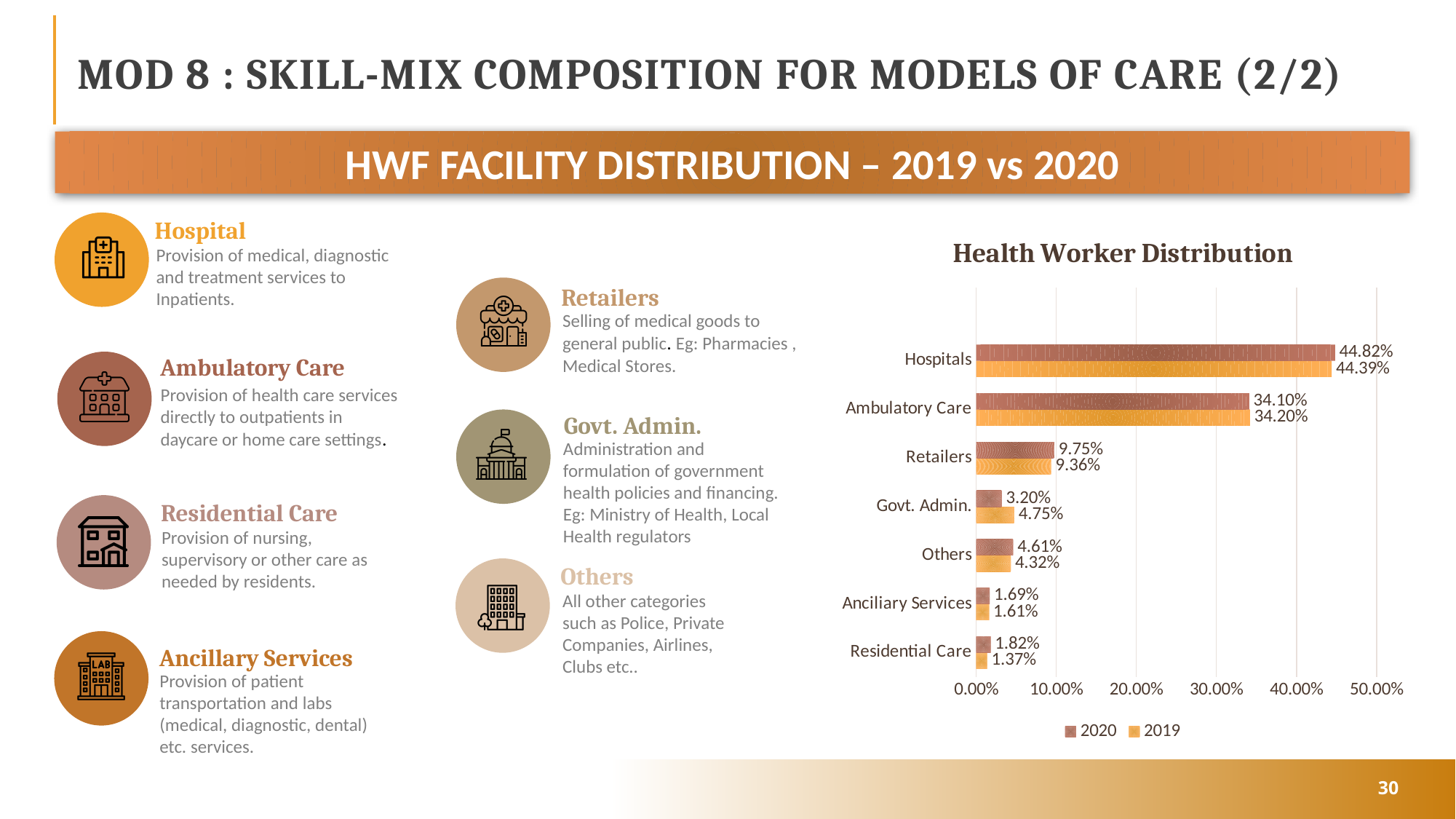
Which category has the lowest 2019 value in the Health Worker Distribution chart? Residential Care What is the 2019 value for Ambulatory Care in the Health Worker Distribution chart? 34.20% How many categories are shown in the Health Worker Distribution chart? 7 Is the 2020 value for Ambulatory Care greater or less than 30.00% in the Health Worker Distribution chart? greater What is the 2019 value for Govt. Admin. in the Health Worker Distribution chart? 4.75% What type of chart is the Health Worker Distribution chart? Bar chart For Govt. Admin., which year has the larger value in the Health Worker Distribution chart, 2020 or 2019? 2019 What is the 2020 value for Hospitals in the Health Worker Distribution chart? 44.82% Which category has the highest 2020 value in the Health Worker Distribution chart? Hospitals How many series does the legend of the Health Worker Distribution chart list? 2 Which series is shown in orange in the Health Worker Distribution chart? 2019 What is the difference between the 2020 and 2019 values for Retailers in the Health Worker Distribution chart? 0.39%